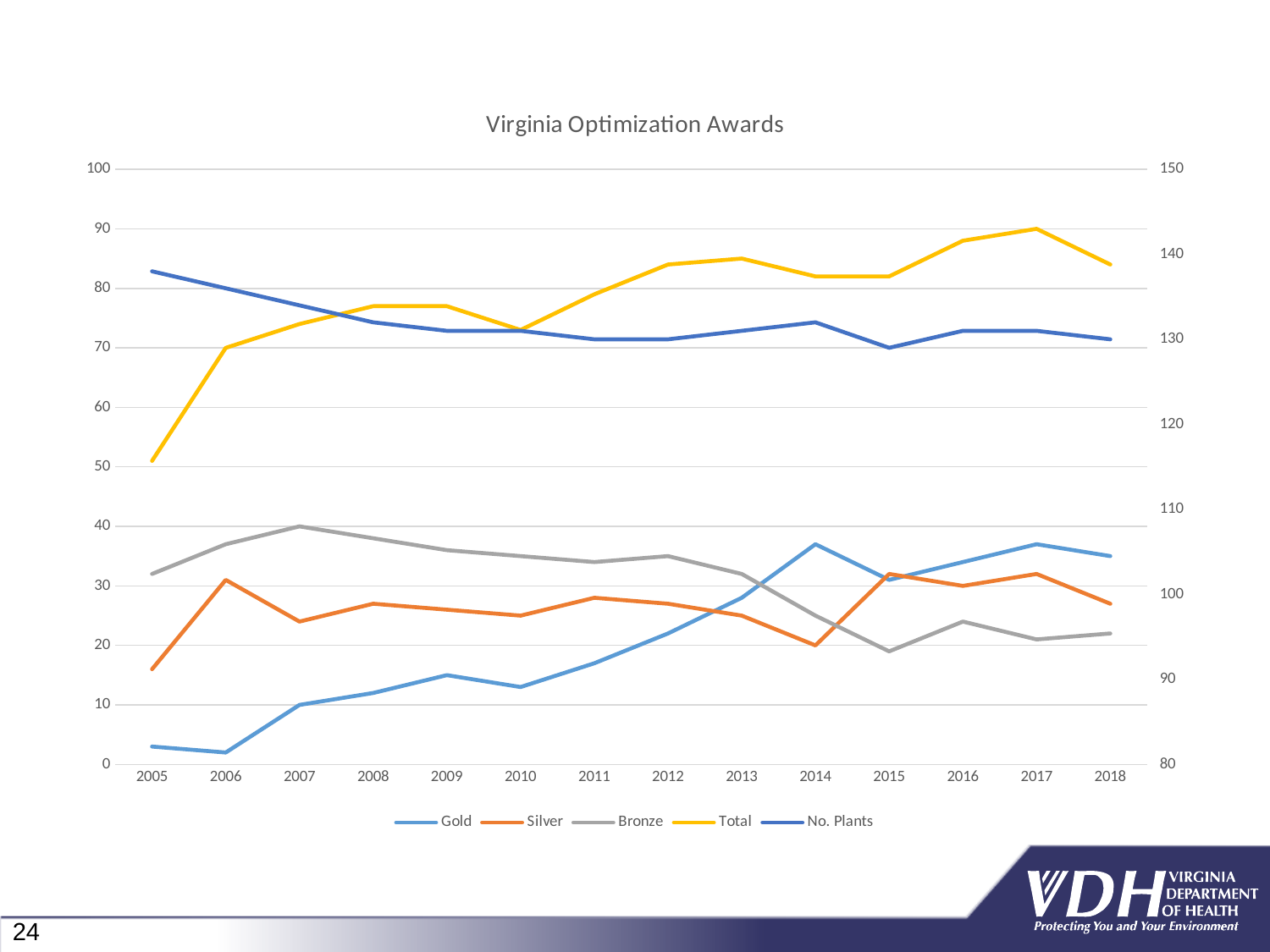
In which year is the Silver series at its lowest? 2005 In which year is the Bronze series at its highest? 2007 In which year is the No. Plants series at its highest? 2005 Is the value for Gold in 2005 greater or less than 10? less Which is larger in 2014, Gold or Silver? Gold What kind of chart is shown on the slide? line chart What is the title of the chart? Virginia Optimization Awards How many series does the legend list? 5 In which year is the Total series at its highest? 2017 Is the value for Gold in 2014 greater or less than 30? greater How many years are shown along the x axis? 14 In which year is the Total series at its lowest? 2005